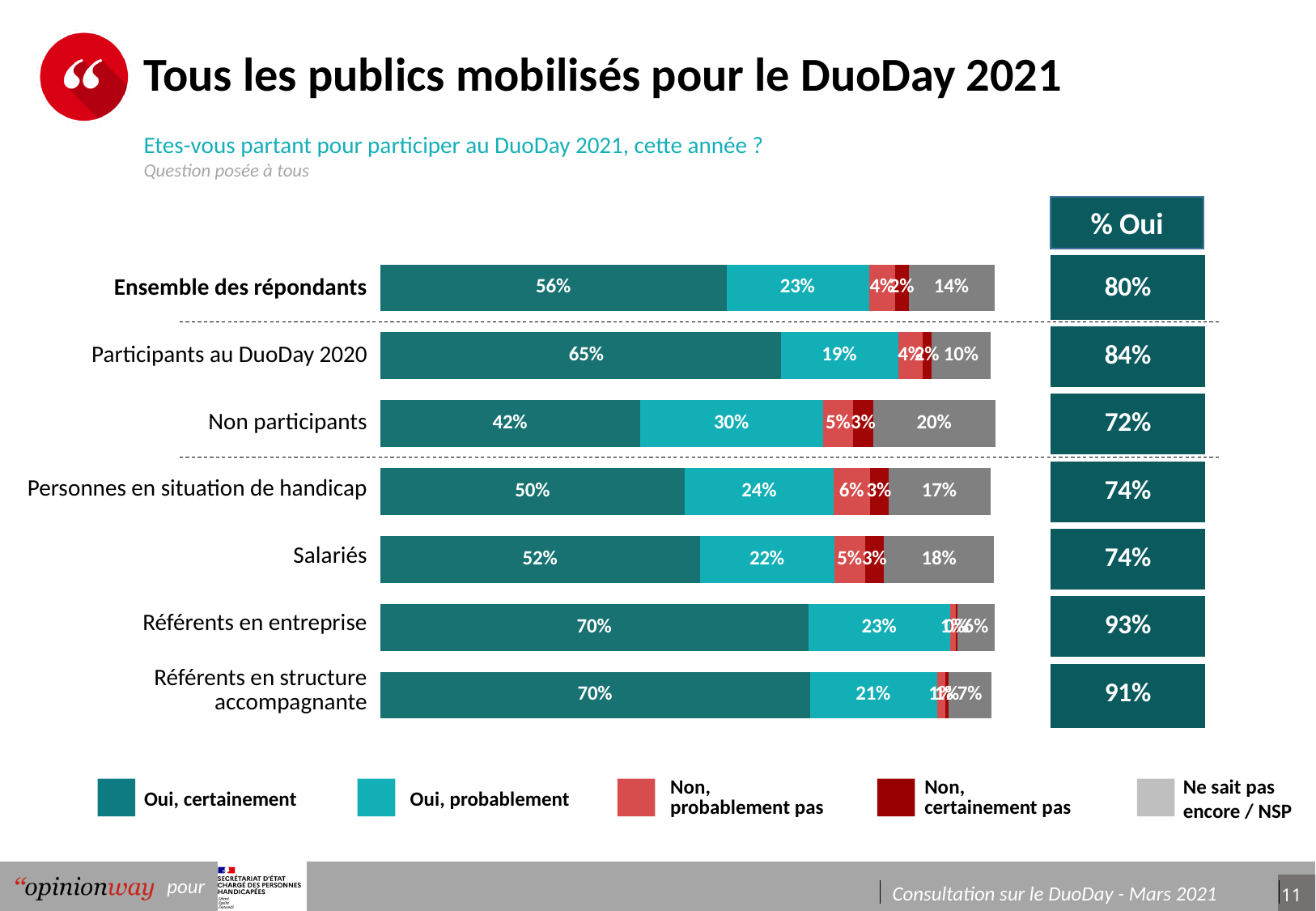
What is the 'Oui, probablement' value for 'Non participants'? 30% What is the difference in 'Oui, certainement' between 'Participants au DuoDay 2020' and 'Non participants'? 23 percentage points What percentage of 'Ensemble des répondants' answered 'Oui, certainement'? 56% How many categories (rows) are shown in the chart? 7 What is the 'Non, probablement pas' value for 'Personnes en situation de handicap'? 6% What kind of chart is shown on the slide? Stacked bar chart Which category has the highest '% Oui' value? Référents en entreprise How many series does the legend list? 5 Which has a larger 'Oui, probablement' value: 'Non participants' or 'Salariés'? Non participants What is the 'Ne sait pas encore / NSP' value for 'Non participants'? 20% Which category has the lowest 'Oui, certainement' value? Non participants What is the '% Oui' value shown for 'Personnes en situation de handicap'? 74%